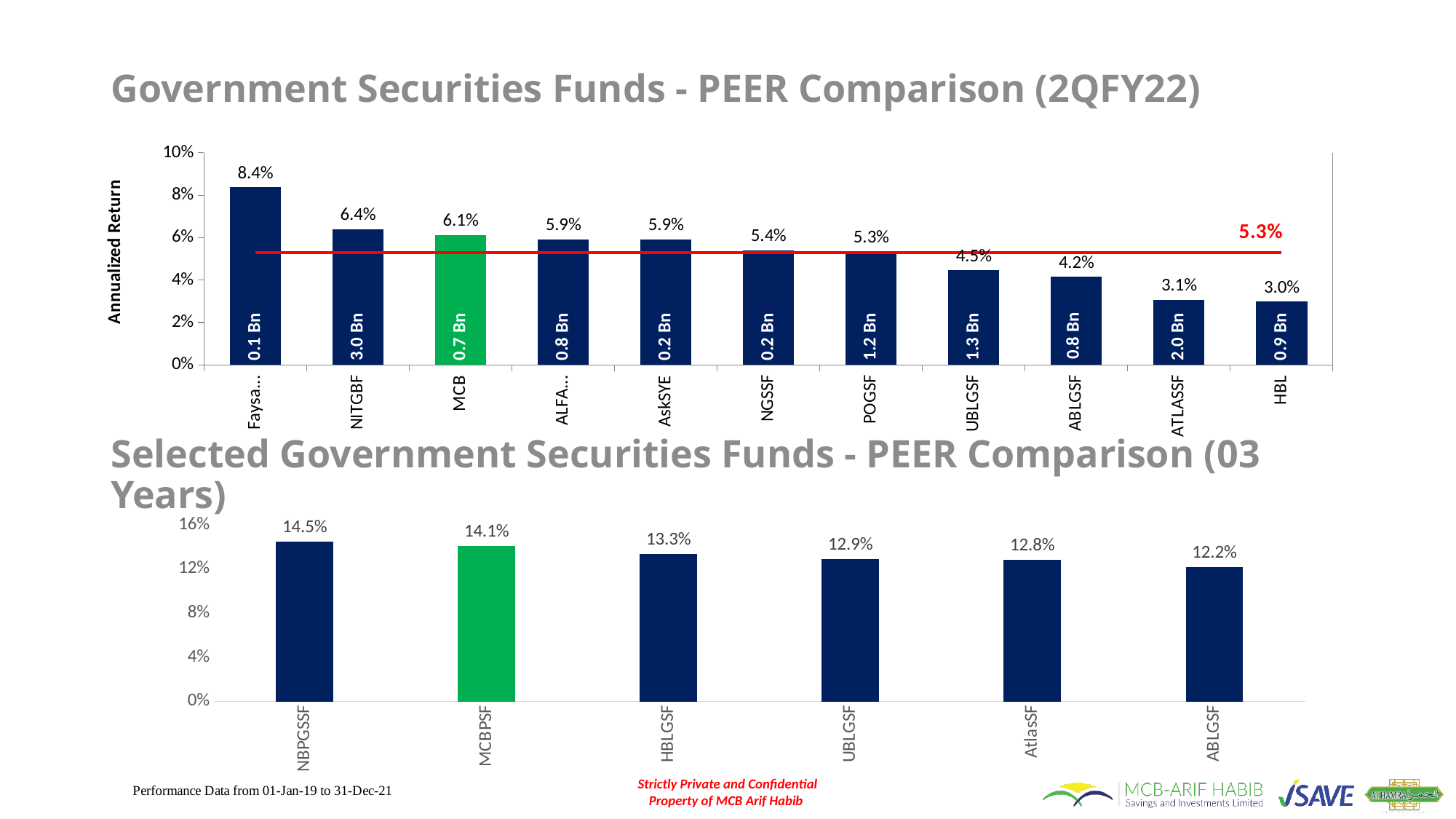
In the top chart (2QFY22), what is the difference between the annualized returns of NITGBF and UBLGSF? 1.9% In the bottom chart (03 Years), which fund has the highest value? NBPGSSF In the bottom chart (03 Years), what is the difference between NBPGSSF and ABLGSF? 2.3% In the top chart (2QFY22), what is the annualized return for MCB? 6.1% In the top chart (Government Securities Funds - PEER Comparison (2QFY22)), what is the annualized return for NITGBF? 6.4% In the top chart (2QFY22), which has the higher annualized return, NGSSF or ABLGSF? NGSSF In the top chart (2QFY22), what value is marked by the red horizontal line? 5.3% In the top chart (2QFY22), how many funds are plotted? 11 What type of chart is the bottom chart (03 Years)? Bar chart In the top chart (2QFY22), what fund size is printed inside the NITGBF bar? 3.0 Bn In the bottom chart (Selected Government Securities Funds - PEER Comparison (03 Years)), what is the value for MCBPSF? 14.1% In the top chart (2QFY22), which fund has the lowest annualized return? HBL